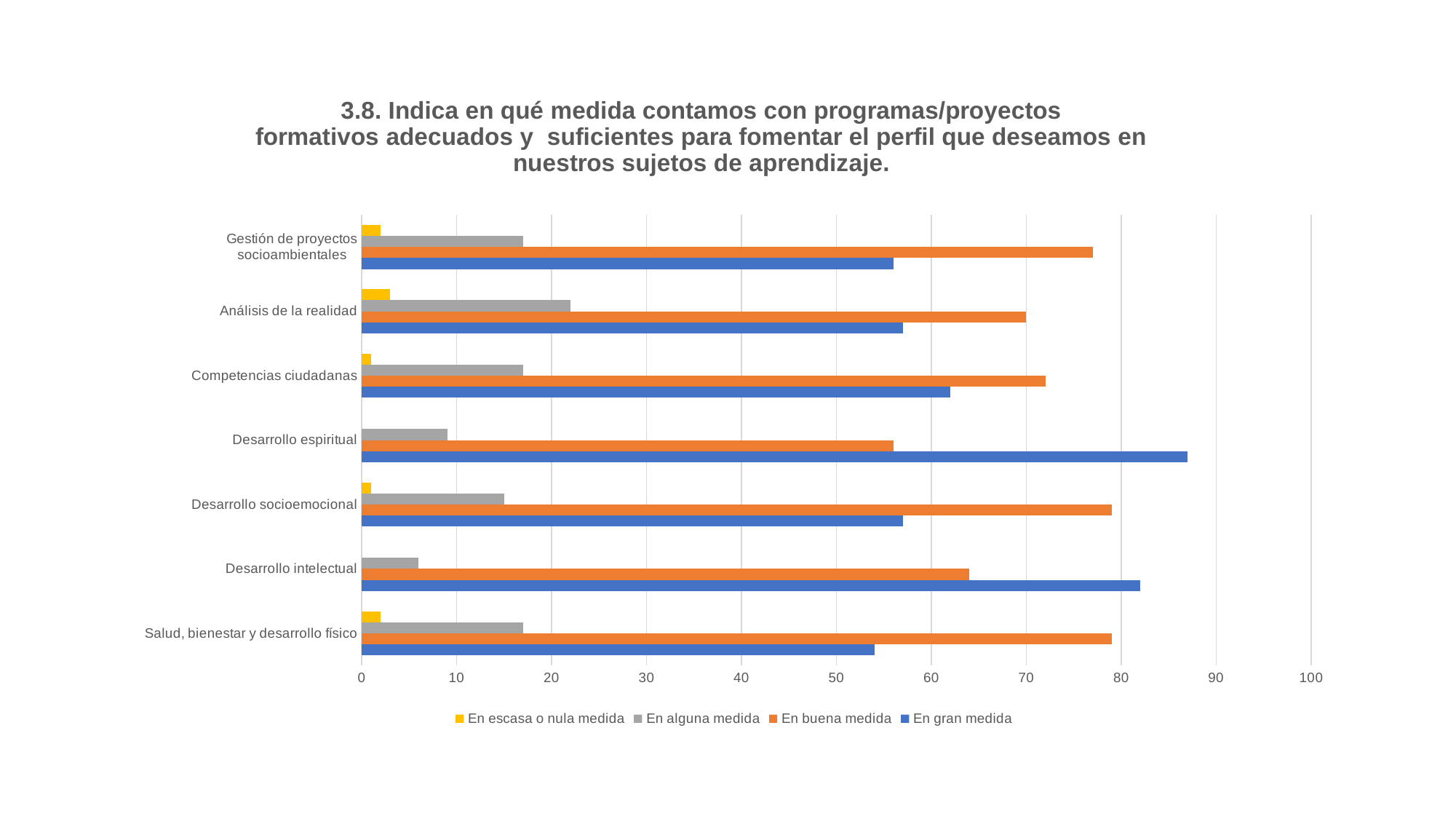
Which legend entry is shown in yellow? En escasa o nula medida Which category has the lowest value for the series 'En buena medida'? Desarrollo espiritual For Desarrollo intelectual, which series has the larger value: 'En buena medida' or 'En gran medida'? En gran medida What kind of chart is shown on the slide? bar chart Is the value of 'En buena medida' for Gestión de proyectos socioambientales greater or less than 70? greater Is the value of 'En gran medida' for Desarrollo espiritual greater or less than 80? greater For Competencias ciudadanas, which series has the larger value: 'En buena medida' or 'En gran medida'? En buena medida How many series does the legend list? 4 Which category has the highest value for the series 'En gran medida'? Desarrollo espiritual How many categories are shown on the vertical axis of the chart? 7 Which category has the highest value for the series 'En alguna medida'? Análisis de la realidad Is the value of 'En gran medida' for Salud, bienestar y desarrollo físico greater or less than 60? less